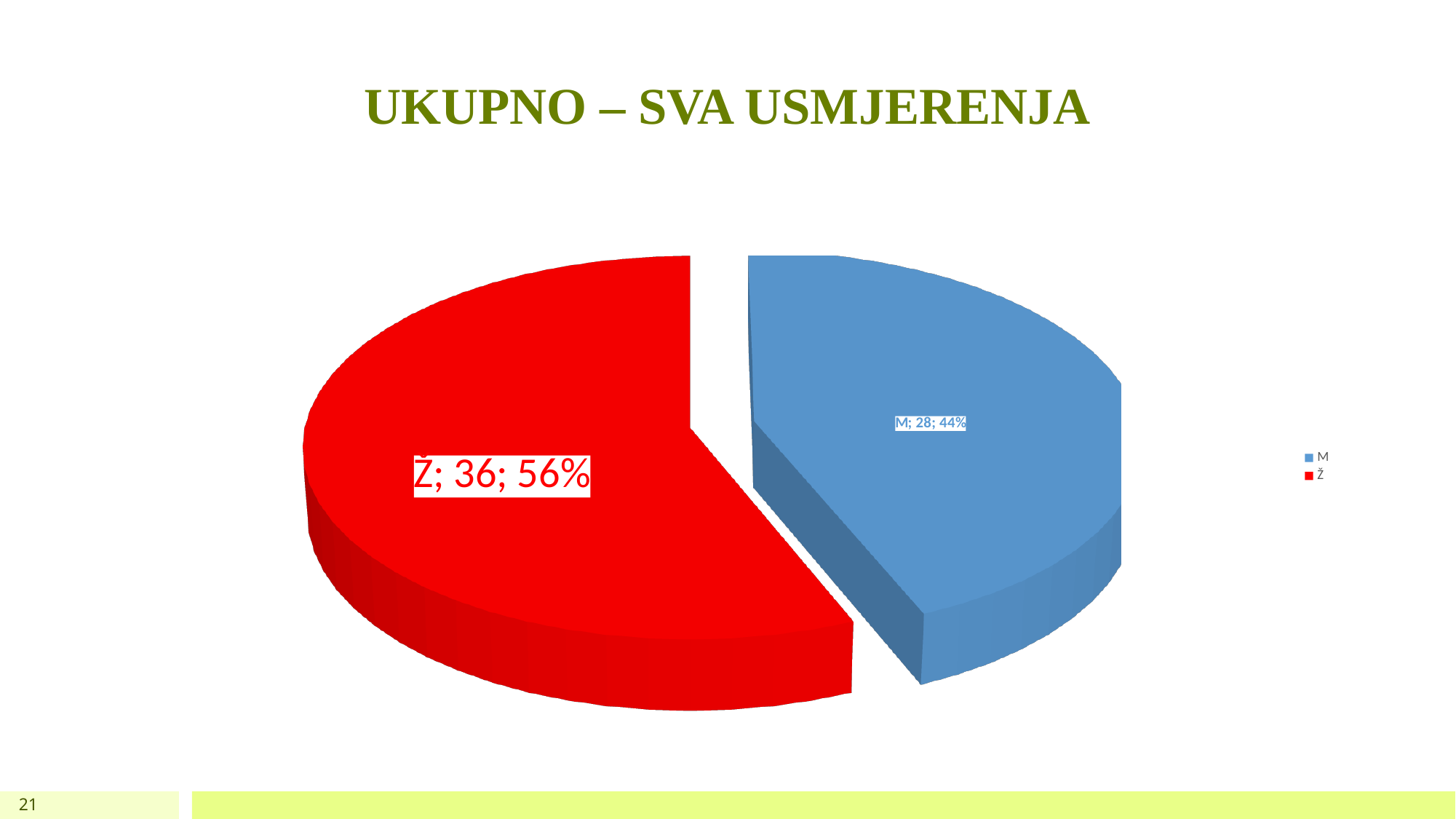
What kind of chart is shown on the slide? pie chart What is the total of the two slices? 64 Which category has the largest slice? Ž Which is larger, the value for M or the value for Ž? Ž What is the value for Ž? 36 Which category has the smallest slice? M What is the title of the slide? UKUPNO – SVA USMJERENJA What is the difference between the values for Ž and M? 8 What is the value for M? 28 How many slices does the pie chart have? 2 What share of the pie does M represent? 44% What share of the pie does Ž represent? 56%